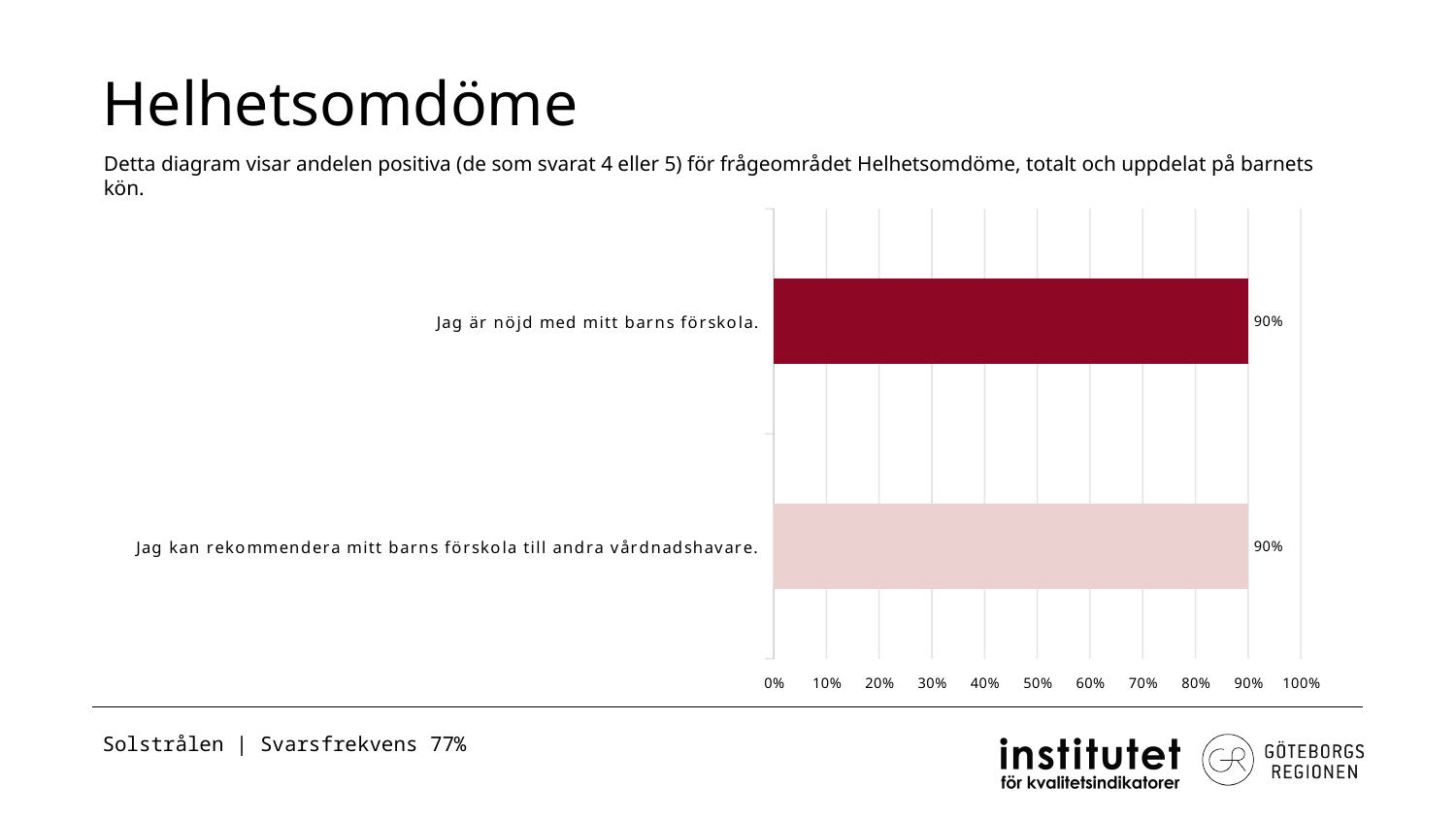
How many categories are shown in the chart? 2 Is the value for "Jag är nöjd med mitt barns förskola." greater or less than 80%? greater What is the value for "Jag kan rekommendera mitt barns förskola till andra vårdnadshavare."? 90% What is the title of the slide containing the chart? Helhetsomdöme What kind of chart is shown on the slide? bar chart What is the difference between the values for "Jag är nöjd med mitt barns förskola." and "Jag kan rekommendera mitt barns förskola till andra vårdnadshavare."? 0% What is the highest value shown on the x axis? 100% Is the value for "Jag kan rekommendera mitt barns förskola till andra vårdnadshavare." greater or less than 100%? less What is the value for "Jag är nöjd med mitt barns förskola."? 90%